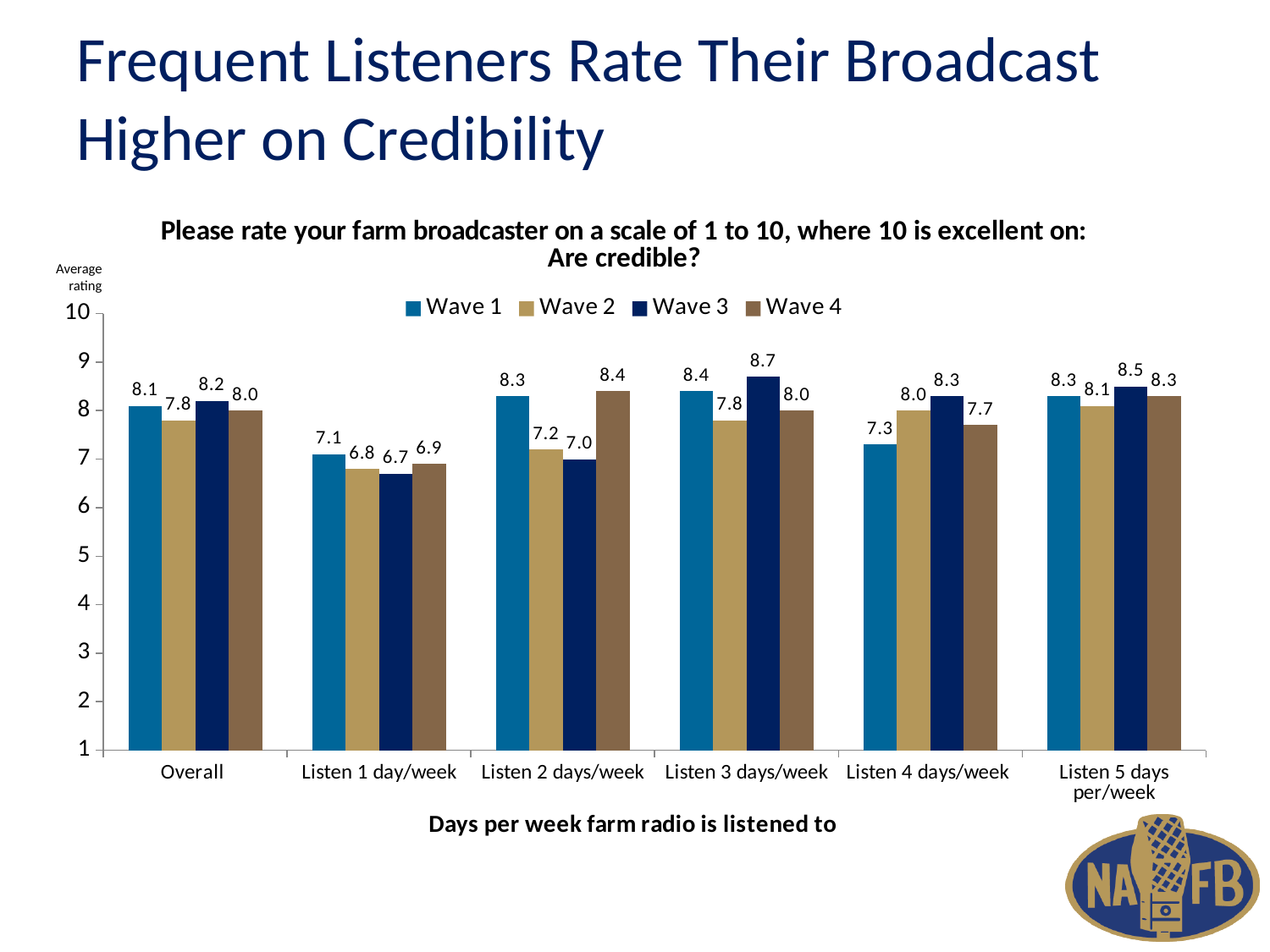
Which category has the lowest Wave 3 rating? Listen 1 day/week What is the Wave 1 average rating for Listen 1 day/week? 7.1 What is the Wave 4 average rating for Listen 2 days/week? 8.4 What is the label on the x axis of the chart? Days per week farm radio is listened to How many series does the legend list? 4 Which category has the highest Wave 3 rating? Listen 3 days/week What is the Wave 2 average rating for the Overall category? 7.8 What is the difference between the Wave 1 and Wave 3 ratings for Listen 4 days/week? 1.0 Which is larger for Listen 2 days/week: the Wave 2 rating or the Wave 4 rating? Wave 4 What is the Wave 3 average credibility rating for Listen 3 days/week? 8.7 How many listening-frequency categories are shown on the x axis? 6 What kind of chart is shown on the slide? Bar chart